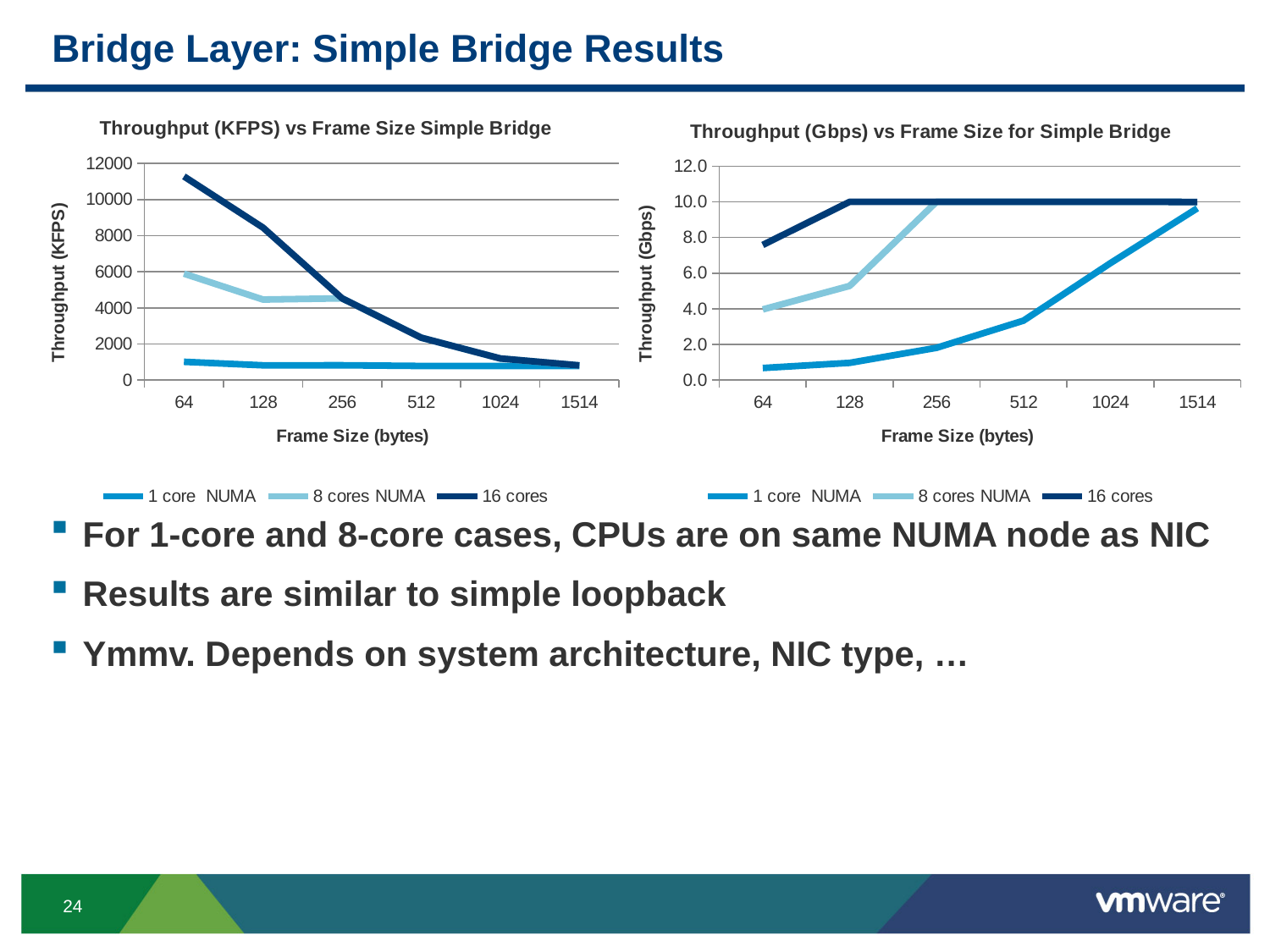
In the right chart, 'Throughput (Gbps) vs Frame Size for Simple Bridge', is the value for 1 core NUMA at frame size 64 greater or less than 2.0? less In the right chart, 'Throughput (Gbps) vs Frame Size for Simple Bridge', does the 1 core NUMA series rise or fall as frame size increases? rise What kind of chart is the left chart, 'Throughput (KFPS) vs Frame Size Simple Bridge'? line chart In the left chart, 'Throughput (KFPS) vs Frame Size Simple Bridge', which series has the highest throughput at frame size 64? 16 cores How many frame sizes are shown on the x axis of the left chart, 'Throughput (KFPS) vs Frame Size Simple Bridge'? 6 In the left chart, 'Throughput (KFPS) vs Frame Size Simple Bridge', is the value for 16 cores at frame size 64 greater or less than 10000? greater In the left chart, 'Throughput (KFPS) vs Frame Size Simple Bridge', is the value for 1 core NUMA at frame size 1514 greater or less than 2000? less In the right chart, 'Throughput (Gbps) vs Frame Size for Simple Bridge', which is larger at frame size 128: 8 cores NUMA or 1 core NUMA? 8 cores NUMA How many series does the legend of the right chart, 'Throughput (Gbps) vs Frame Size for Simple Bridge', list? 3 In the left chart, 'Throughput (KFPS) vs Frame Size Simple Bridge', does the 16 cores series rise or fall as frame size increases? fall What is the x-axis label of the right chart, 'Throughput (Gbps) vs Frame Size for Simple Bridge'? Frame Size (bytes)